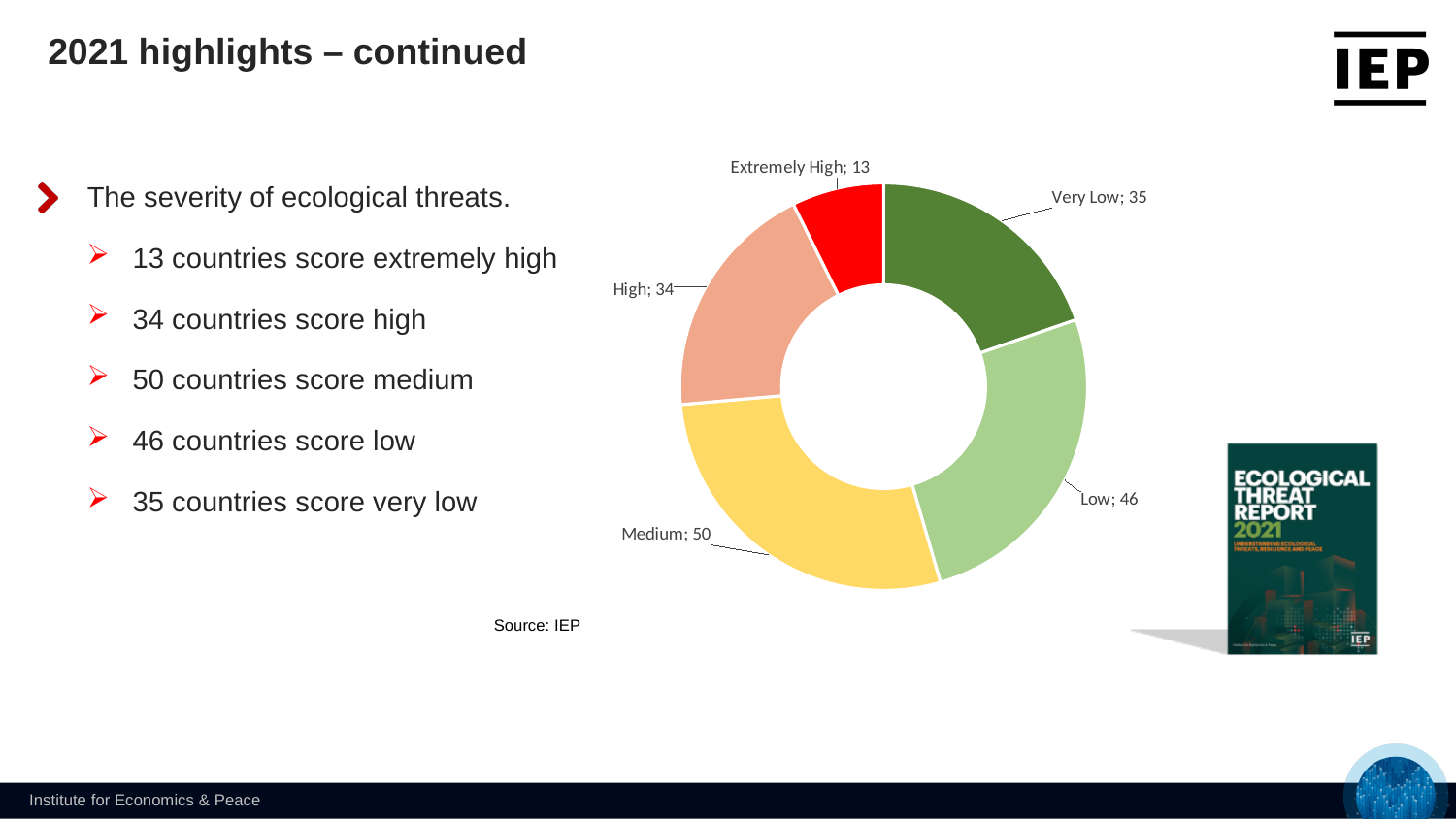
What value is shown for the Very Low segment of the chart? 35 What value is shown for the Extremely High segment of the chart? 13 What is the difference between the Medium and Extremely High values in the chart? 37 Which category has the smallest segment in the chart? Extremely High Which category has the largest segment in the chart? Medium What type of chart is shown on the slide? doughnut chart Which is larger in the chart, Very Low or High? Very Low What is the difference between the Low and High values in the chart? 12 What is the total of all segments in the chart? 178 How many categories are shown in the chart? 5 What colour is the Extremely High segment in the chart? red How many countries score Medium in the doughnut chart? 50